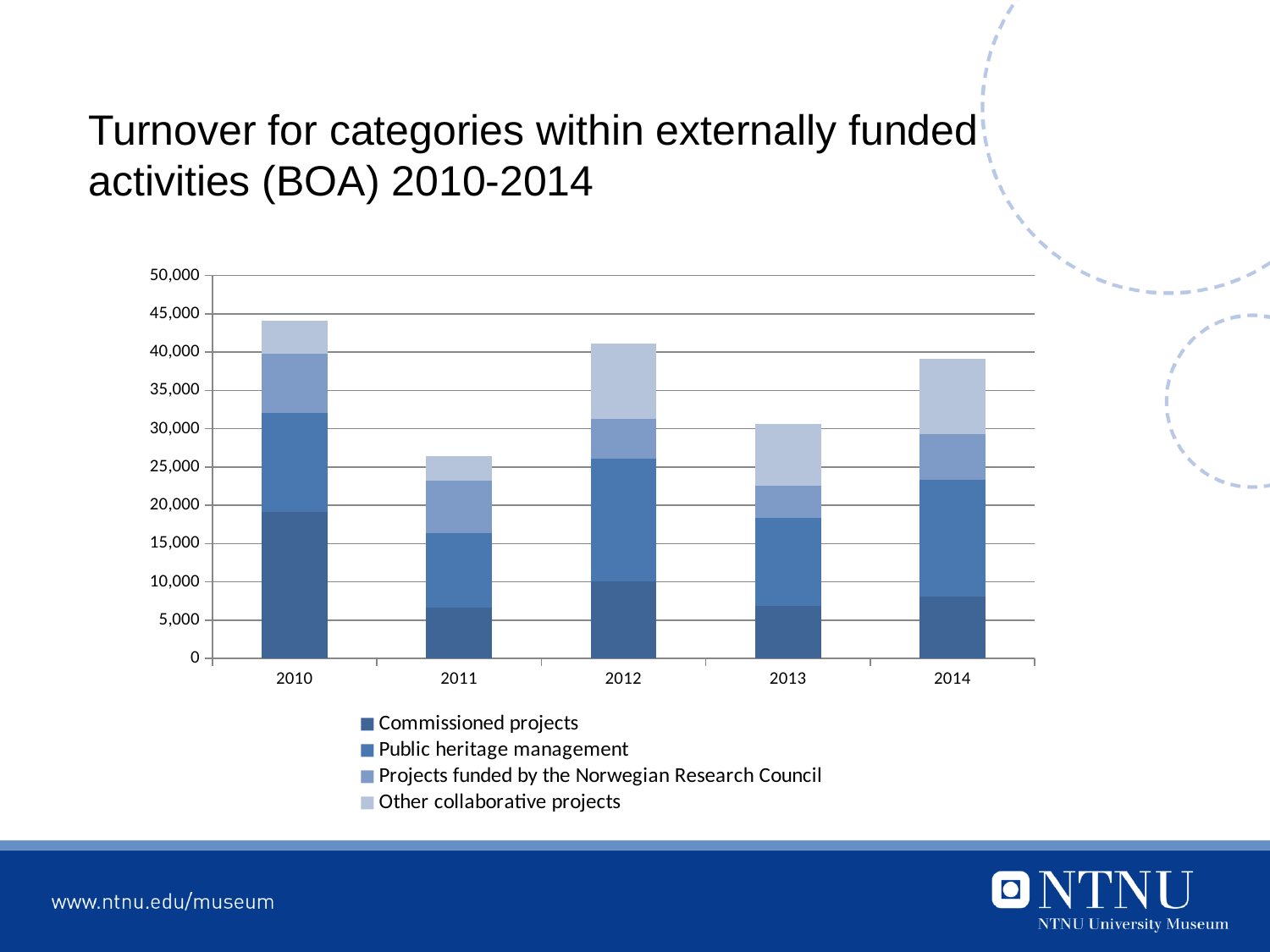
Which year has the larger value for Commissioned projects, 2012 or 2013? 2012 Which year has the larger total turnover, 2010 or 2011? 2010 Is the total turnover for 2011 greater or less than 30,000? less Which year has the highest total turnover in the chart? 2010 Is the value for Commissioned projects in 2010 greater or less than 15,000? greater Which legend entry is shown in the lightest shade of blue? Other collaborative projects How many series does the chart's legend list? 4 Is the total turnover for 2010 greater or less than 40,000? greater How many years are shown on the x axis of the chart? 5 Which year has the lowest total turnover in the chart? 2011 What kind of chart is shown on the slide? Stacked bar chart